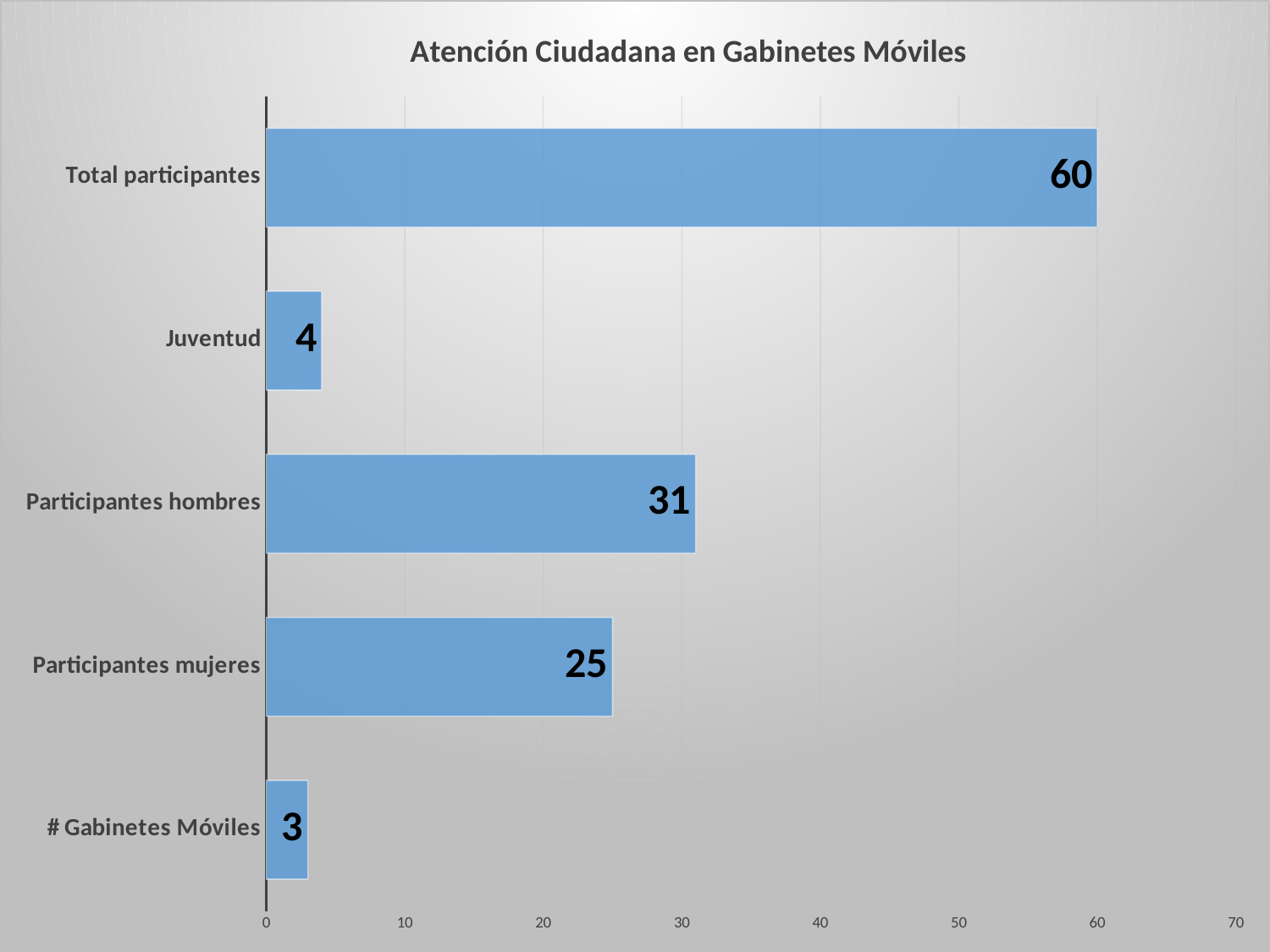
Which is larger, Participantes hombres or Participantes mujeres? Participantes hombres How many categories are shown in the chart? 5 What is the title of the chart? Atención Ciudadana en Gabinetes Móviles What kind of chart is this? Bar chart What is the value for Total participantes? 60 What is the difference between Participantes hombres and Participantes mujeres? 6 Which category has the lowest value? # Gabinetes Móviles What is the value for Juventud? 4 What is the value for # Gabinetes Móviles? 3 Which category has the highest value? Total participantes What is the value for Participantes hombres? 31 What is the value for Participantes mujeres? 25